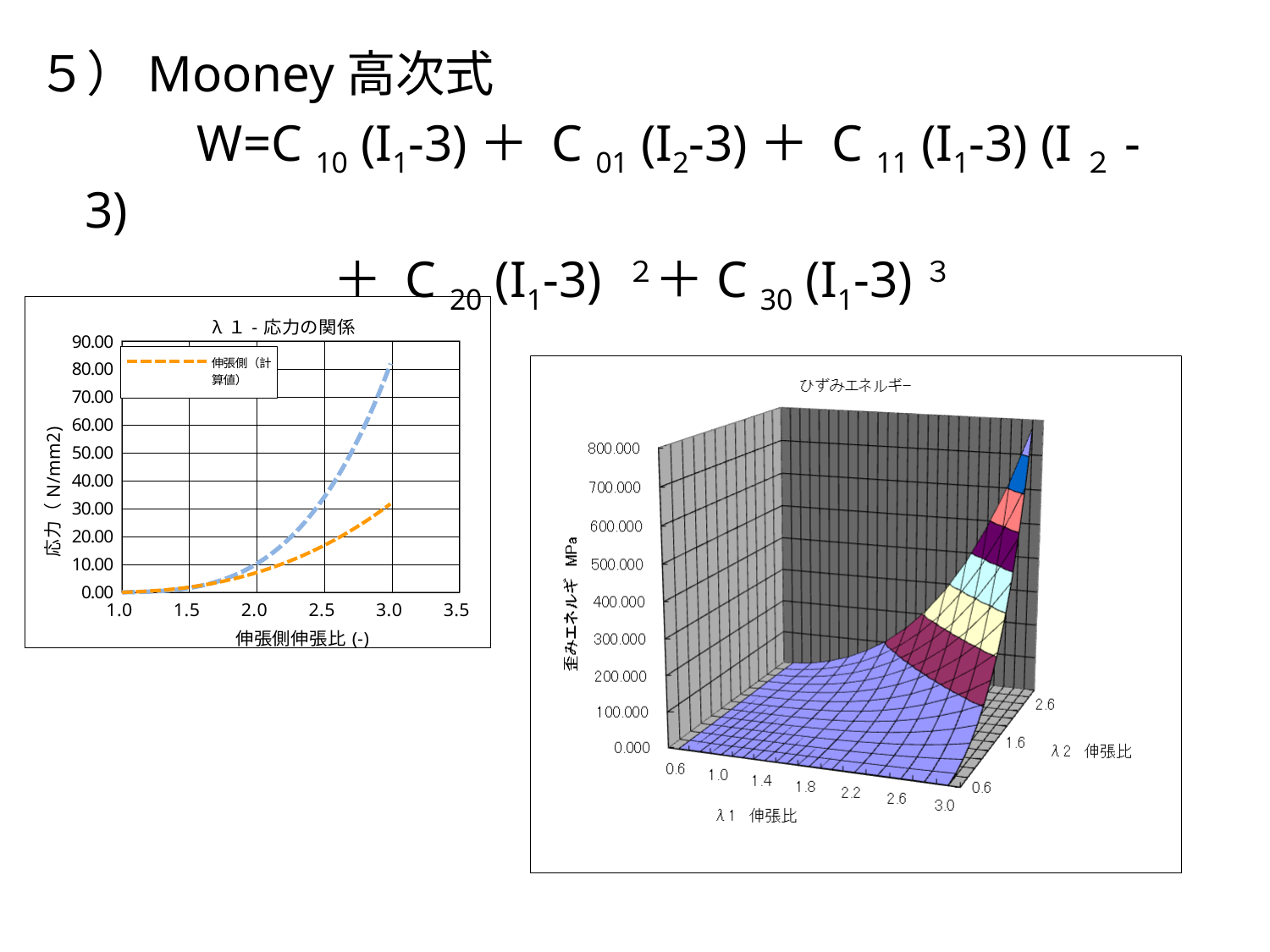
In the right chart (ひずみエネルギー), does the strain energy rise or fall as λ1 伸張比 increases? rise What is the x-axis label of the left chart (λ１-応力の関係)? 伸張側伸張比 (-) In the left chart (λ１-応力の関係), do the plotted lines rise or fall as the x-axis value increases? rise In the left chart (λ１-応力の関係), is the value of the blue dashed line at x = 3.0 greater or less than 70.00? greater In the right chart (ひずみエネルギー), is the peak value of the surface greater or less than 600.000? greater In the left chart (λ１-応力の関係), which line is higher at x = 3.0, the blue dashed line or the orange dashed line? the blue dashed line How many dashed lines are plotted in the left chart (λ１-応力の関係)? 2 What kind of chart is the chart on the right of the slide (ひずみエネルギー)? 3D surface chart In the left chart (λ１-応力の関係), is the value of the orange dashed line at x = 3.0 greater or less than 40.00? less What kind of chart is the chart on the left of the slide (λ１-応力の関係)? line chart What is the title of the chart on the left of the slide? λ１-応力の関係